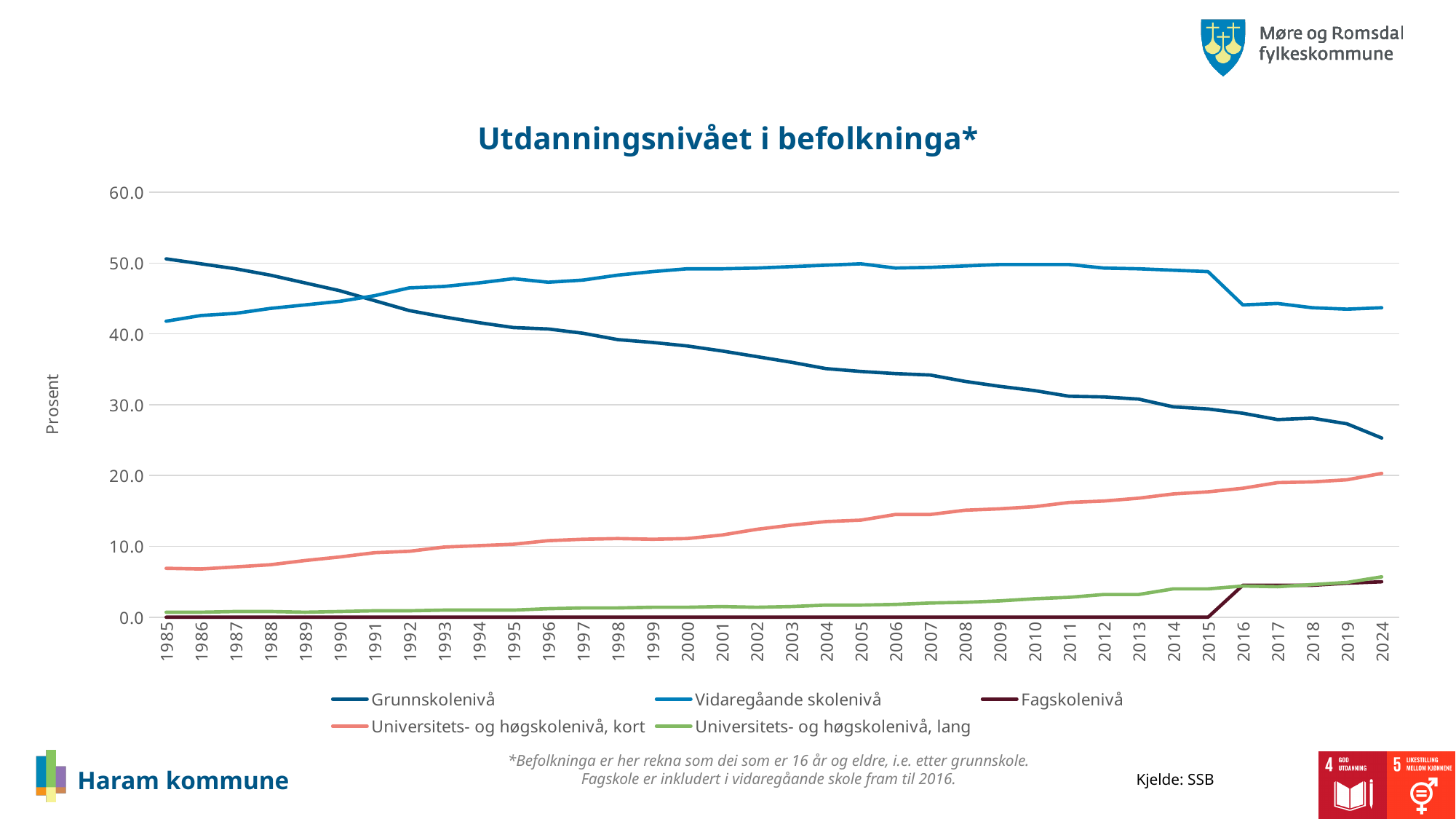
What is the label on the y axis? Prosent Is the value for Grunnskolenivå in 2024 greater or less than 30.0? less Is the value for Vidaregåande skolenivå in 2024 greater or less than 40.0? greater Which series has the highest value in 2024? Vidaregåande skolenivå Which series has the lowest value in 1985? Fagskolenivå How many series does the legend list? 5 In 1985, which is larger: Grunnskolenivå or Vidaregåande skolenivå? Grunnskolenivå What is the title of the chart? Utdanningsnivået i befolkninga* How many years are shown along the x axis? 36 Does the value for Grunnskolenivå rise or fall from 1985 to 2024? Fall What kind of chart is shown on the slide? Line chart Does the value for Universitets- og høgskolenivå, kort rise or fall from 1985 to 2024? Rise